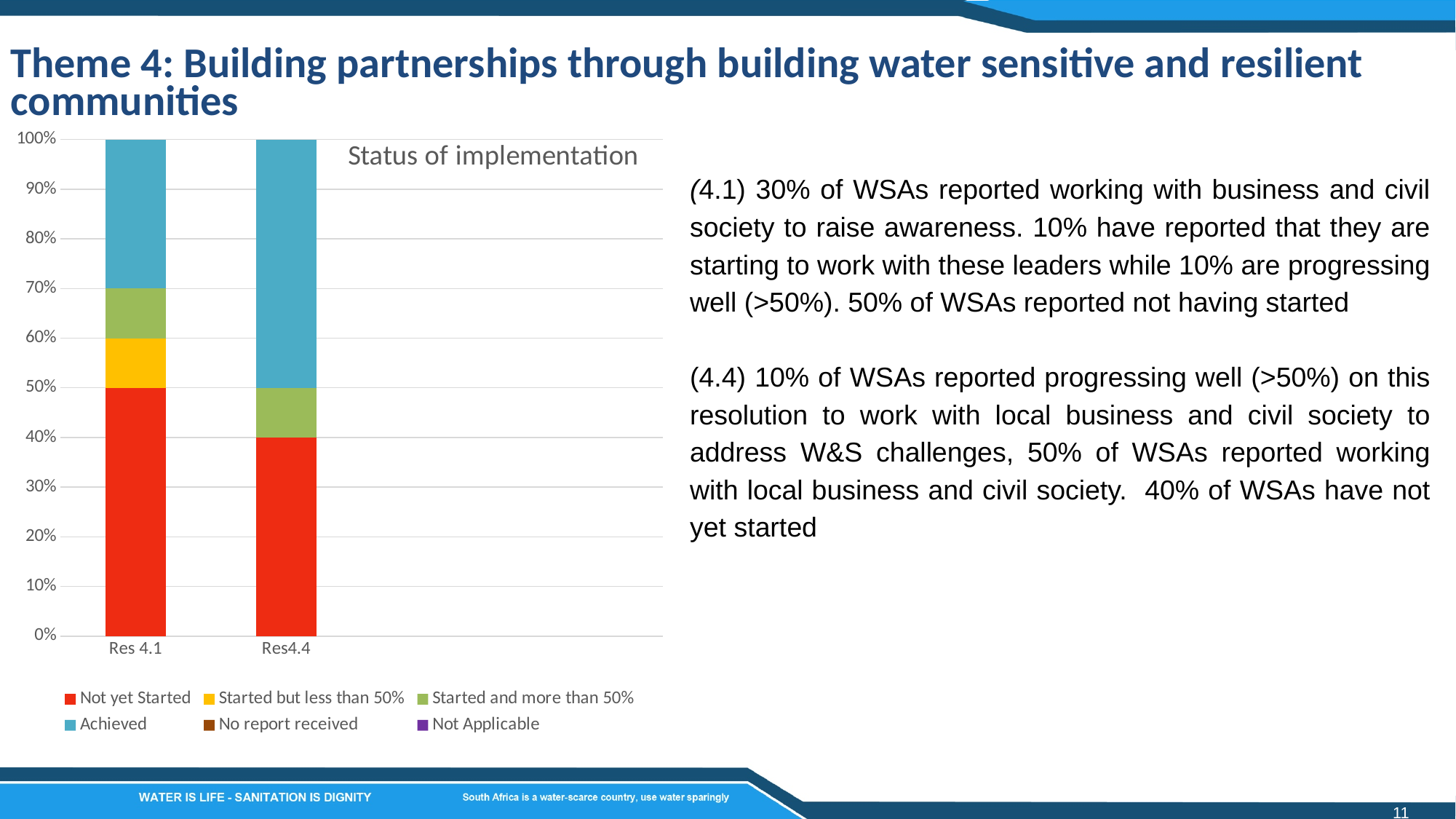
Which category has the larger 'Not yet Started' segment, Res 4.1 or Res4.4? Res 4.1 Is the 'Achieved' segment for Res 4.1 greater or less than 40%? less What share of WSAs are in the 'Not yet Started' category for Res 4.1? 50% What is the total height of the stacked bar for Res4.4? 100% How many categories are shown on the x axis of the chart? 2 What is the title of the chart? Status of implementation Which category includes a 'Started but less than 50%' segment? Res 4.1 How many series does the chart legend list? 6 What kind of chart is shown on the slide? stacked bar chart Which category has the larger 'Achieved' segment, Res 4.1 or Res4.4? Res4.4 Is the 'Achieved' segment for Res4.4 greater or less than 40%? greater What share of WSAs are in the 'Not yet Started' category for Res4.4? 40%